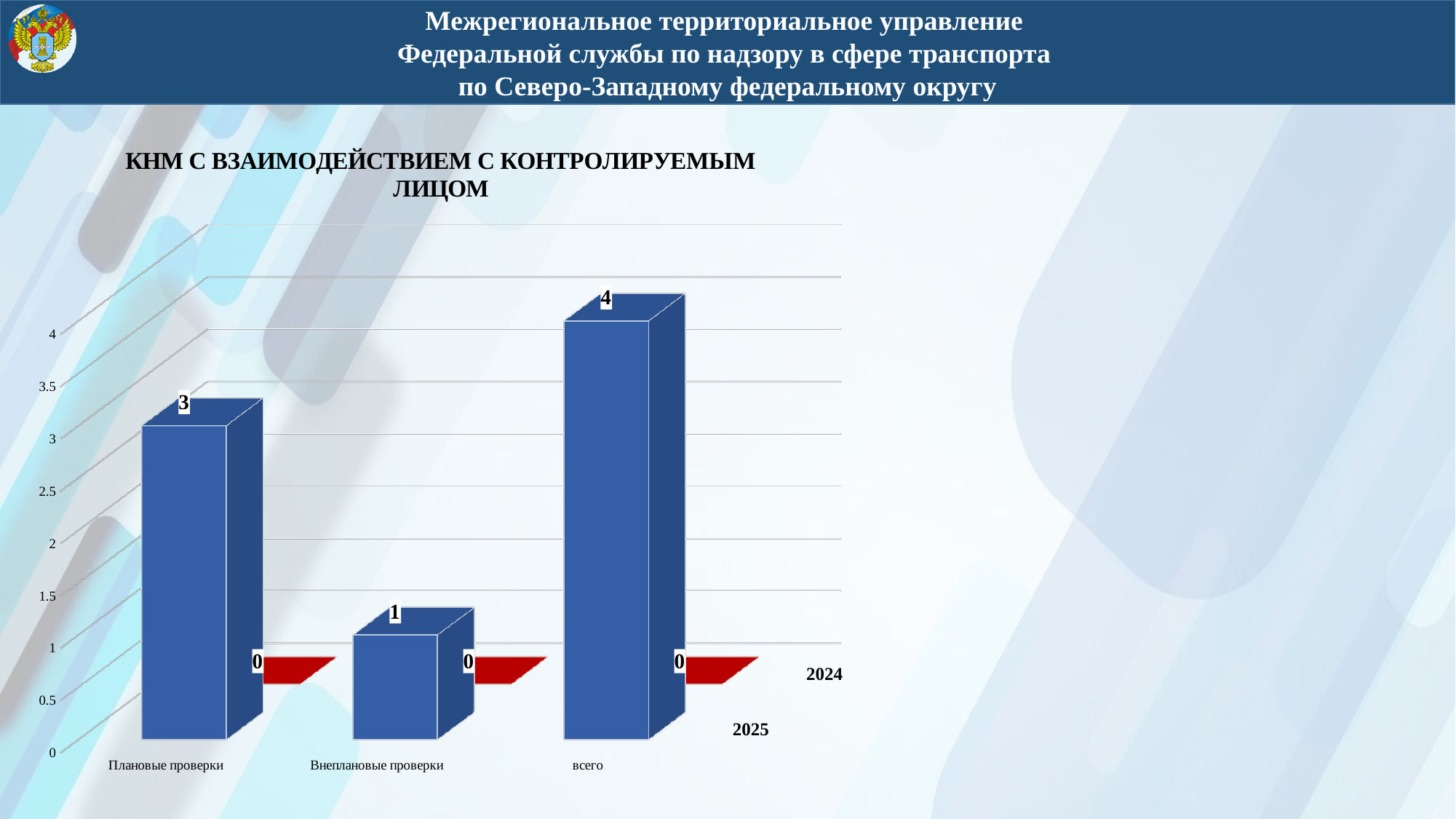
What is the value for Плановые проверки in the 2025 series? 3 What is the difference between the 2025 values for Плановые проверки and Внеплановые проверки? 2 What type of chart is shown on the slide? bar chart How many categories are shown on the x axis? 3 What is the value for Внеплановые проверки in the 2025 series? 1 Which category has the highest value in the 2025 series? всего How many data series does the chart show? 2 What is the value for Плановые проверки in the 2024 series? 0 What is the title of the chart? КНМ С ВЗАИМОДЕЙСТВИЕМ С КОНТРОЛИРУЕМЫМ ЛИЦОМ Which is larger in the 2025 series: Плановые проверки or Внеплановые проверки? Плановые проверки What is the value for всего in the 2025 series? 4 Which category has the lowest value in the 2025 series? Внеплановые проверки